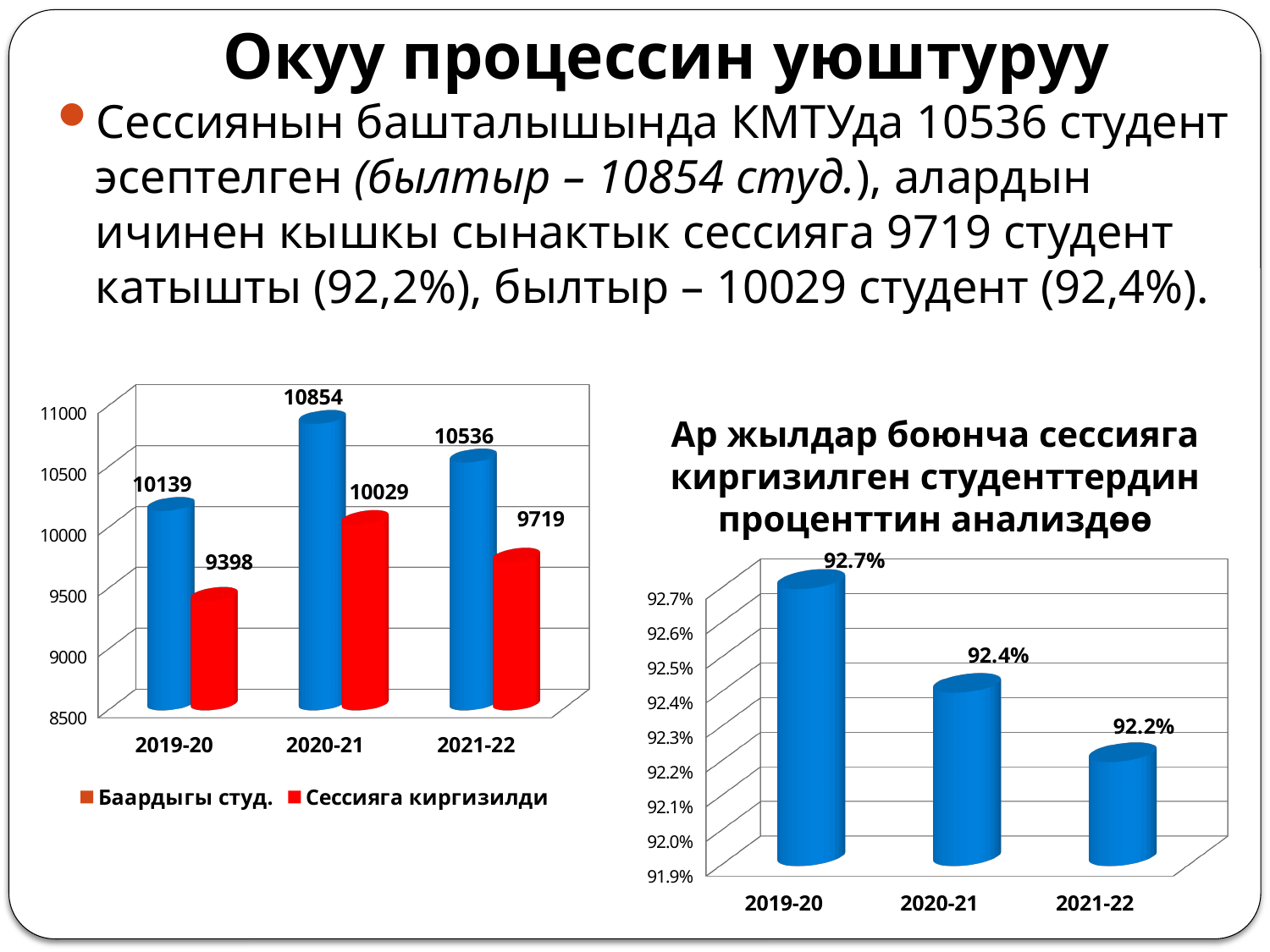
In the left chart, what is the value of Сессияга киргизилди for 2021-22? 9719 In the chart titled 'Ар жылдар боюнча сессияга киргизилген студенттердин проценттин анализдөө', what is the value for 2021-22? 92.2% In the left chart, which year has the highest value for Баардыгы студ.? 2020-21 In the left chart, which year has the lowest value for Сессияга киргизилди? 2019-20 In the chart titled 'Ар жылдар боюнча сессияга киргизилген студенттердин проценттин анализдөө', what is the value for 2019-20? 92.7% In the left chart, how many series does the legend list? 2 In the chart titled 'Ар жылдар боюнча сессияга киргизилген студенттердин проценттин анализдөө', do the values rise or fall from 2019-20 to 2021-22? fall In the left chart, what is the value of Сессияга киргизилди for 2019-20? 9398 In the left chart, what is the value of Баардыгы студ. for 2020-21? 10854 In the chart titled 'Ар жылдар боюнча сессияга киргизилген студенттердин проценттин анализдөө', how many years are shown on the x axis? 3 In the left chart, what is the difference between Баардыгы студ. and Сессияга киргизилди for 2021-22? 817 What kind of chart is the chart on the right of the slide? bar chart